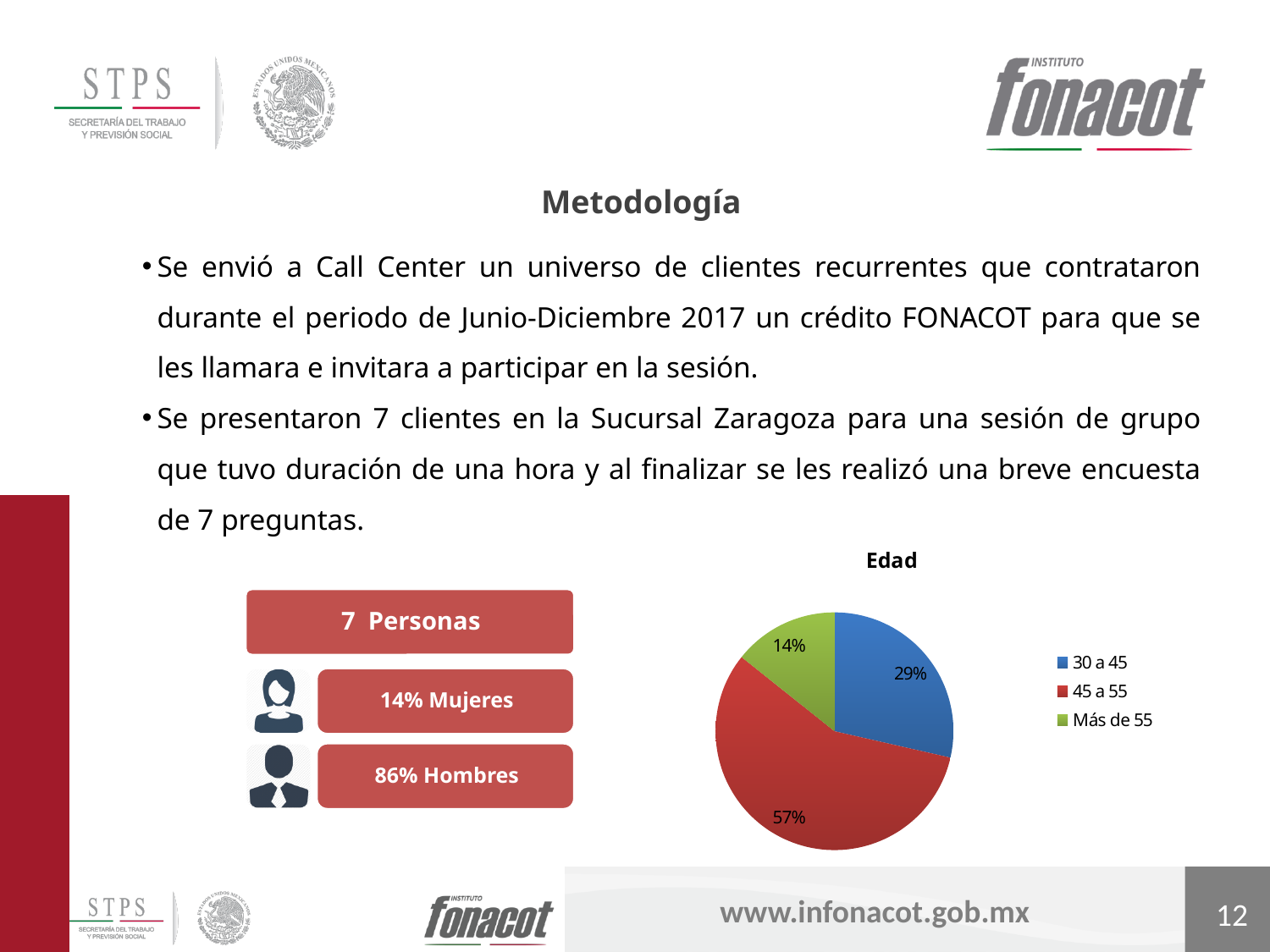
In the 'Edad' pie chart, what share is shown for the '45 a 55' slice? 57% What kind of chart is the 'Edad' chart? pie chart In the 'Edad' pie chart, what share is shown for the '30 a 45' slice? 29% In the 'Edad' pie chart, what share is shown for the 'Más de 55' slice? 14% Which age group has the smallest slice in the 'Edad' pie chart? Más de 55 Which age group has the largest slice in the 'Edad' pie chart? 45 a 55 In the 'Edad' pie chart, which colour represents the '45 a 55' group? red In the 'Edad' pie chart, what is the difference in percentage points between the '45 a 55' slice and the '30 a 45' slice? 28 How many slices does the 'Edad' pie chart have? 3 In the 'Edad' pie chart, which slice is larger: '30 a 45' or 'Más de 55'? 30 a 45 How many entries does the legend of the 'Edad' pie chart list? 3 What is the title of the pie chart on the slide? Edad